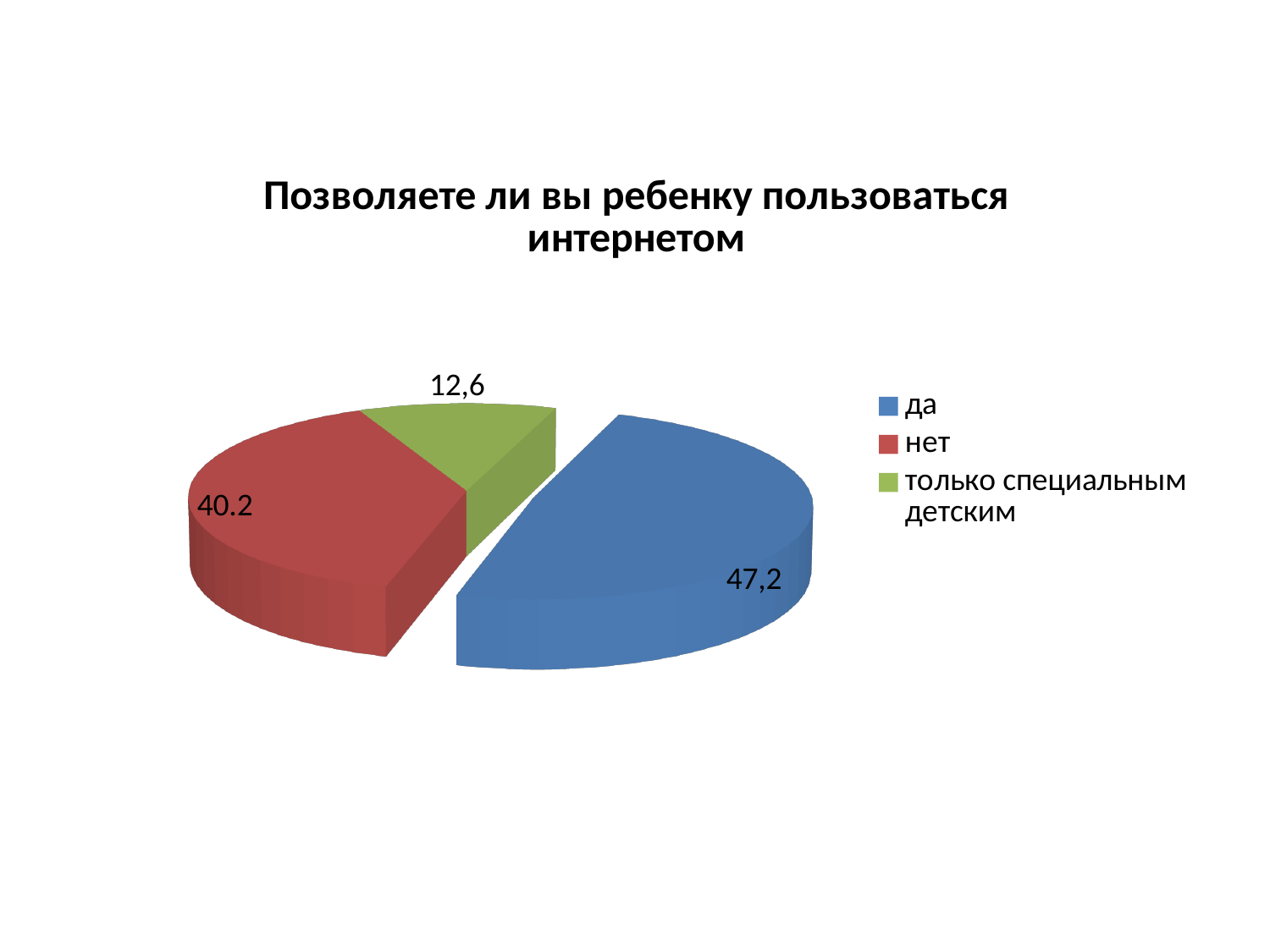
How many slices does the pie chart have? 3 What is the value shown for the "только специальным детским" slice? 12,6 What colour is the "нет" slice? Red Which category has the smallest slice of the pie? только специальным детским What is the value shown for the "да" slice? 47,2 Which is larger, the value for "нет" or the value for "только специальным детским"? нет What is the title of the chart? Позволяете ли вы ребенку пользоваться интернетом What kind of chart is shown on the slide? Pie chart Which is larger, the value for "да" or the value for "нет"? да What is the value shown for the "нет" slice? 40.2 Which category has the largest slice of the pie? да